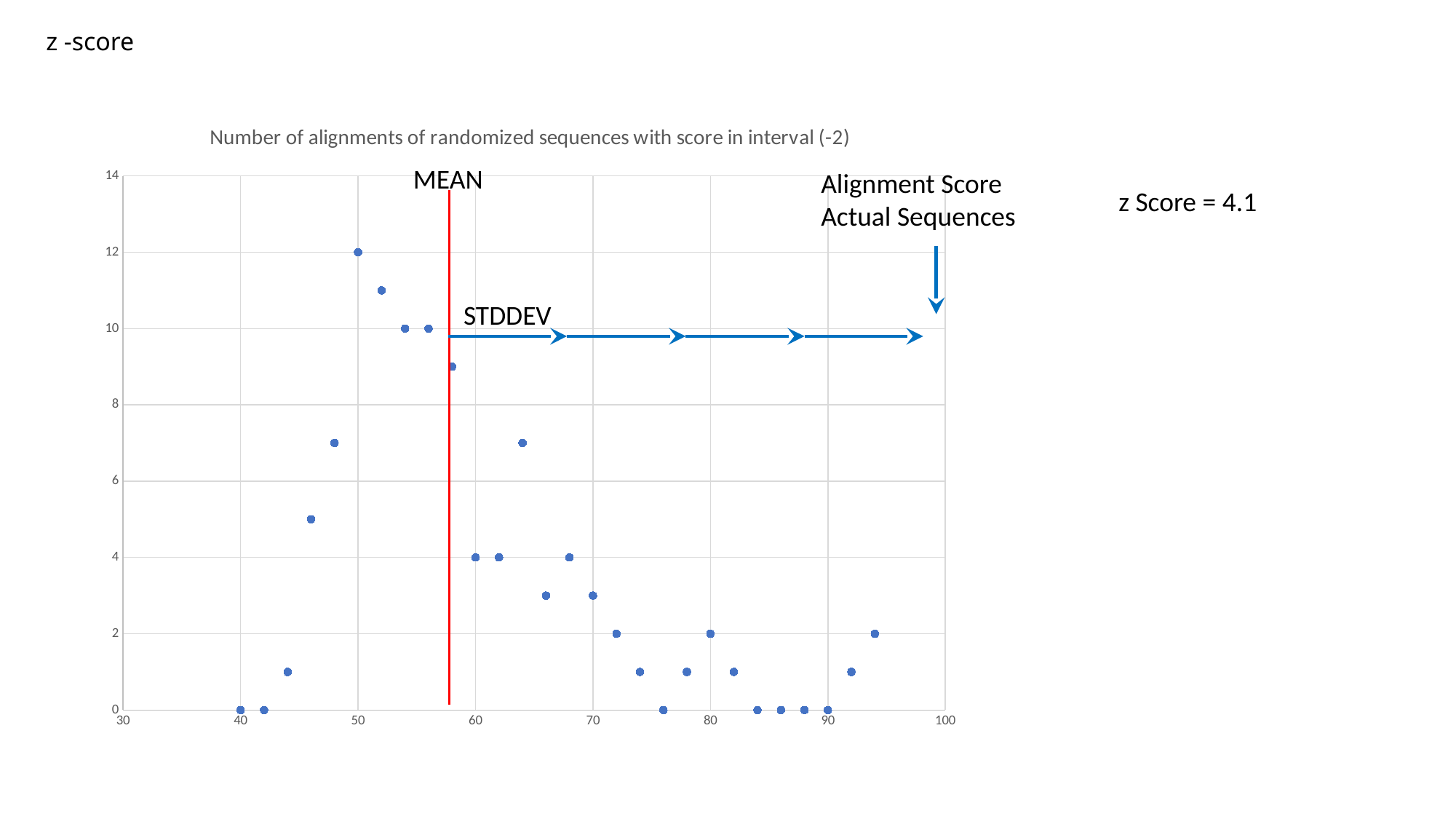
Is the y value of the point at x = 52 greater or less than 10? greater Is the y value of the point at x = 64 greater or less than 6? greater Is the y value of the point at x = 74 greater or less than 2? less Do the y values generally rise or fall as x increases from 50 to 90? fall What is the title of the chart? Number of alignments of randomized sequences with score in interval (-2) What kind of chart is shown on the slide? scatter chart What is the y value of the point at x = 60? 4 At which x value does the highest point occur? 50 What is the y value of the point at x = 50? 12 What is the difference between the y values of the points at x = 50 and x = 60? 8 Which point has the larger y value, the one at x = 50 or the one at x = 80? x = 50 What is the y value of the point at x = 80? 2